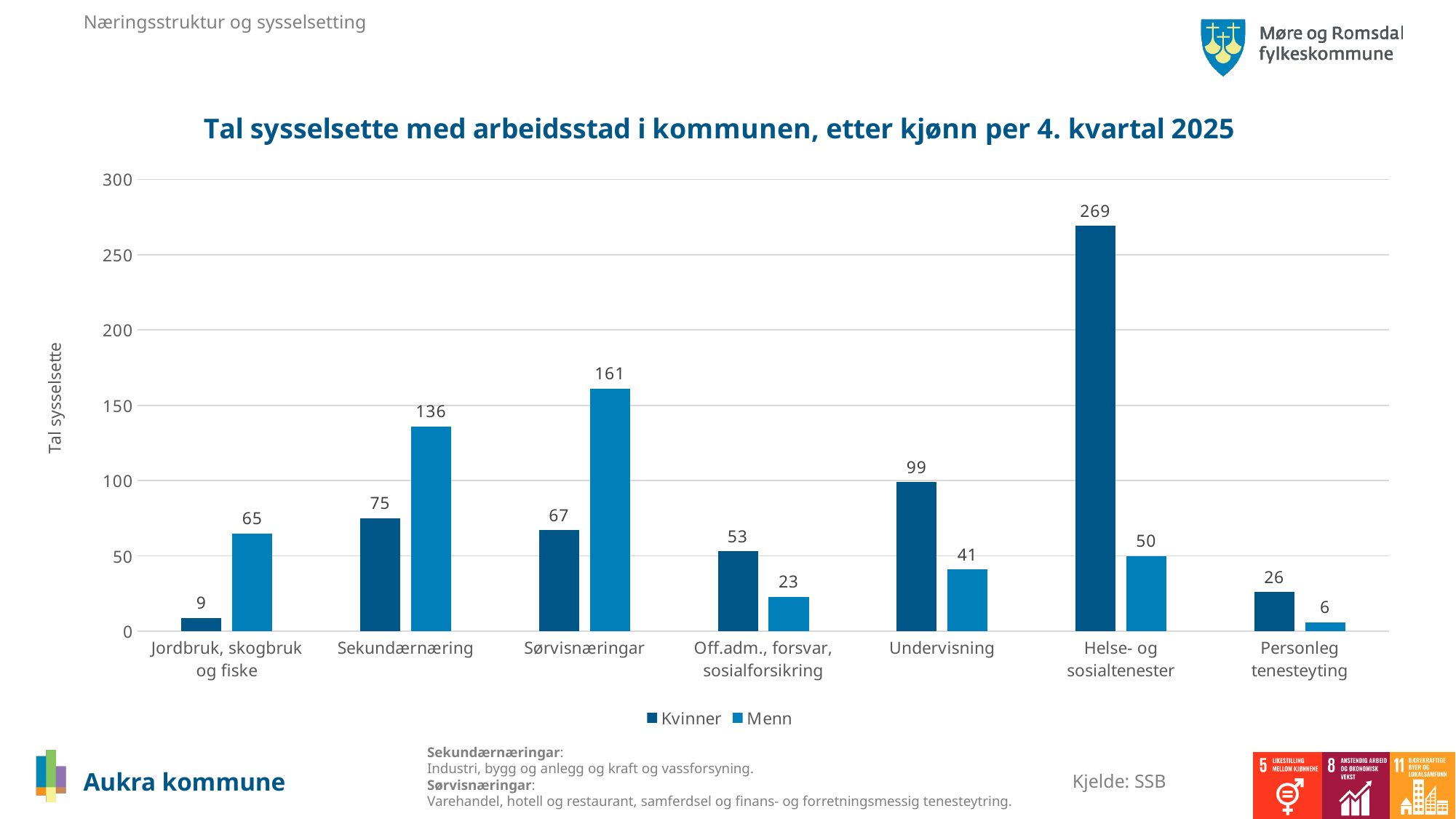
Which is larger in Undervisning, Kvinner or Menn? Kvinner Which category has the highest value for Menn? Sørvisnæringar What is the difference between Kvinner and Menn in Helse- og sosialtenester? 219 Which category has the lowest value for Menn? Personleg tenesteyting What is the source cited on the slide? SSB What kind of chart is shown? Bar chart How many series does the legend list? 2 What is the value for Menn in Sekundærnæring? 136 How many categories are shown on the x axis? 7 What is the value for Kvinner in Helse- og sosialtenester? 269 What is the value for Kvinner in Jordbruk, skogbruk og fiske? 9 Is the value for Menn in Sørvisnæringar greater or less than 150? greater